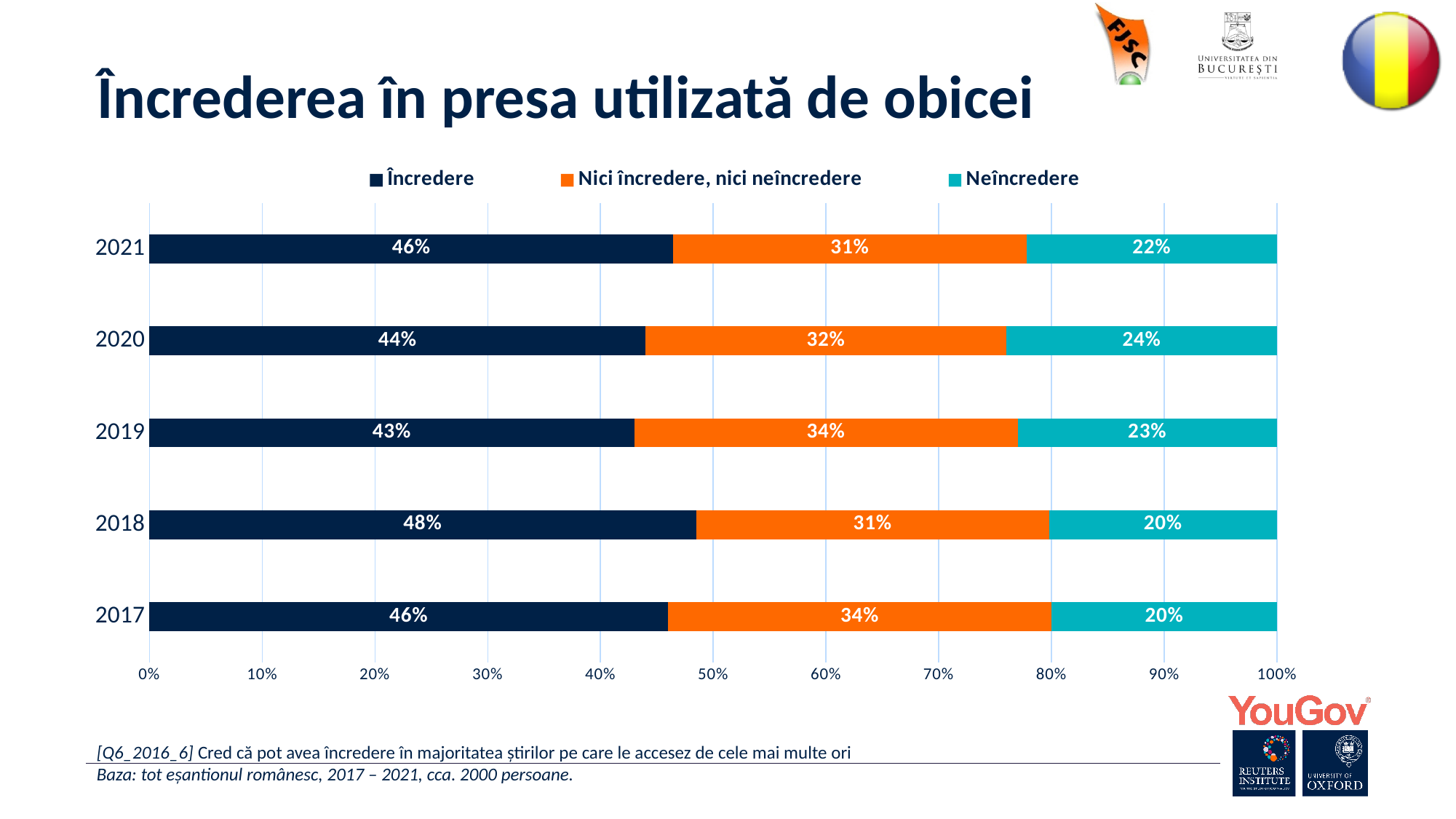
What is the value for Nici încredere, nici neîncredere in 2019? 34% How many series does the legend list? 3 What colour represents Neîncredere in the legend? Teal (light blue) What is the value for Neîncredere in 2020? 24% What is the total of the stacked bar for 2021? 99% How many years are shown on the chart? 5 What is the difference between the Încredere values for 2018 and 2019? 5% What kind of chart is shown on the slide? Stacked bar chart Which year has the lowest value for Încredere? 2019 What is the value for Încredere in 2021? 46% Is the Neîncredere value larger in 2020 or in 2017? 2020 Which year has the highest value for Încredere? 2018